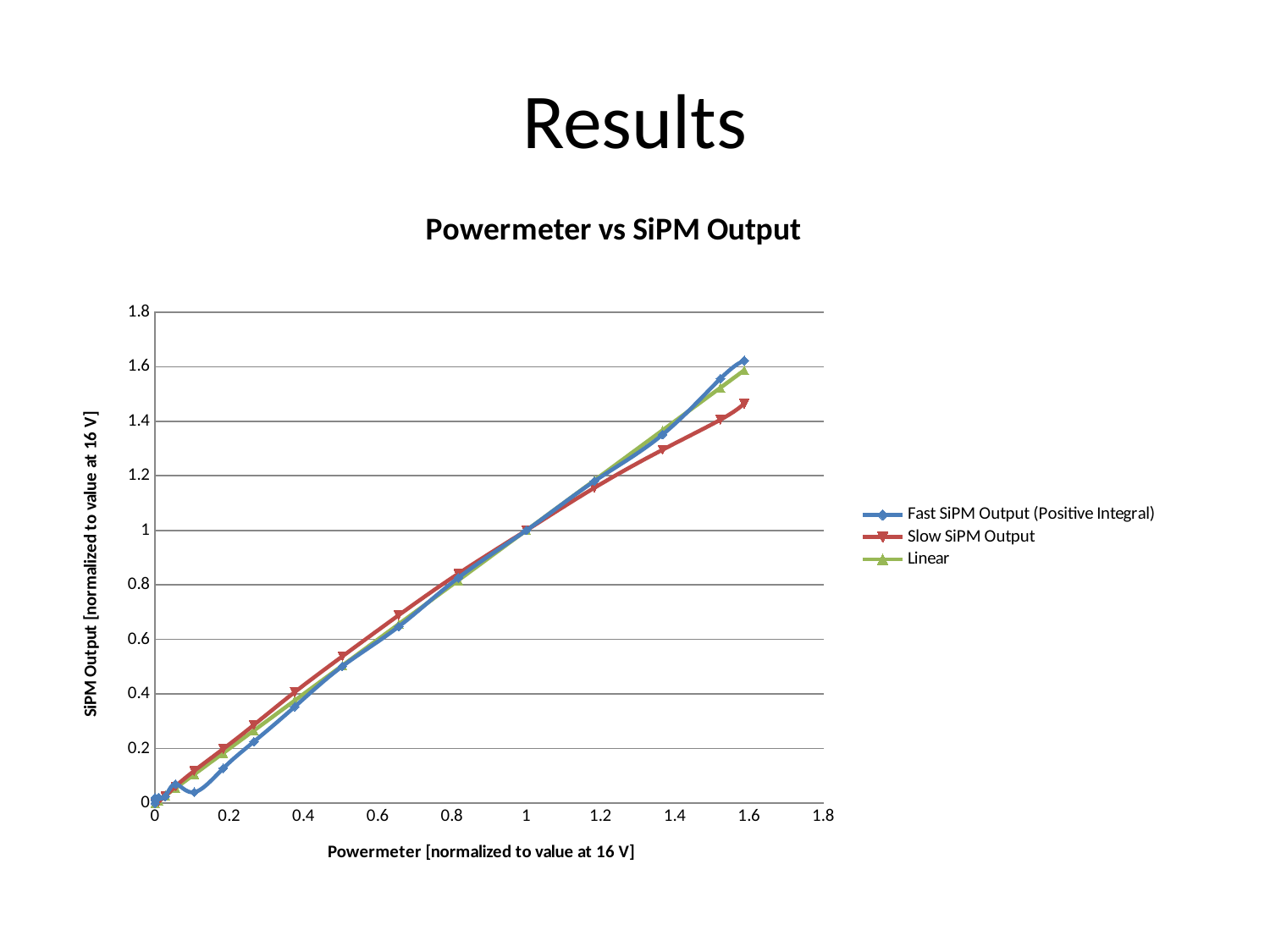
What is the maximum value shown on the y axis? 1.8 What is the label of the x axis? Powermeter [normalized to value at 16 V] Is the Fast SiPM Output (Positive Integral) value at the rightmost data point greater or less than 1.4? greater Do the values of the Fast SiPM Output (Positive Integral) series rise or fall as the Powermeter value increases? Rise At the rightmost data point (Powermeter about 1.6), which series is higher: Fast SiPM Output (Positive Integral) or Slow SiPM Output? Fast SiPM Output (Positive Integral) Do the values of the Slow SiPM Output series rise or fall along the x axis? Rise What kind of chart is shown on the slide? Line chart Which series reaches the highest SiPM Output value on the chart? Fast SiPM Output (Positive Integral) Is the Slow SiPM Output value at Powermeter 0.4 greater or less than 0.6? less Is the Slow SiPM Output value at the rightmost data point greater or less than 1.6? less What is the title of the chart? Powermeter vs SiPM Output How many series does the legend list? 3